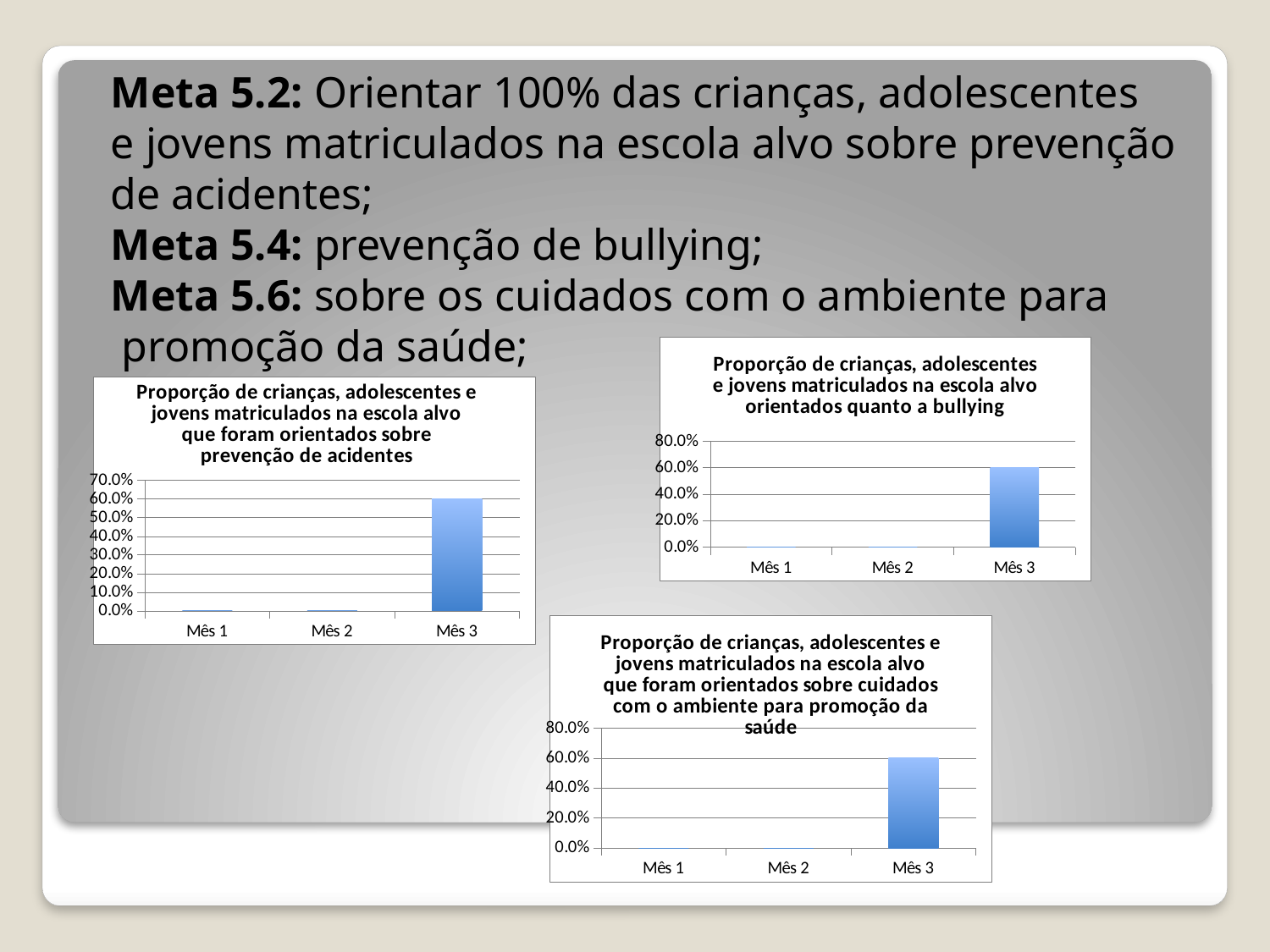
In the chart about cuidados com o ambiente (bottom right), is the value for Mês 3 greater or less than 40.0%? greater In the chart about bullying (top right), is the value for Mês 1 greater or less than 20.0%? less In the chart about cuidados com o ambiente (bottom right), what is the value for Mês 3? 60.0% In the chart about bullying (top right), which is larger, the value for Mês 2 or the value for Mês 3? Mês 3 In the chart about bullying (top right), what is the value for Mês 3? 60.0% In the chart about prevenção de acidentes (left), is the value for Mês 3 greater or less than 50.0%? greater In the chart about prevenção de acidentes (left), how many categories are on the x axis? 3 In the chart about bullying (top right), do the values rise or fall from Mês 1 to Mês 3? rise In the chart about prevenção de acidentes (left), what is the highest value shown on the y axis? 70.0% In the chart about cuidados com o ambiente (bottom right), what is the highest value shown on the y axis? 80.0% In the chart about prevenção de acidentes (left), what kind of chart is shown? bar chart In the chart about prevenção de acidentes (left), which month has the highest value? Mês 3